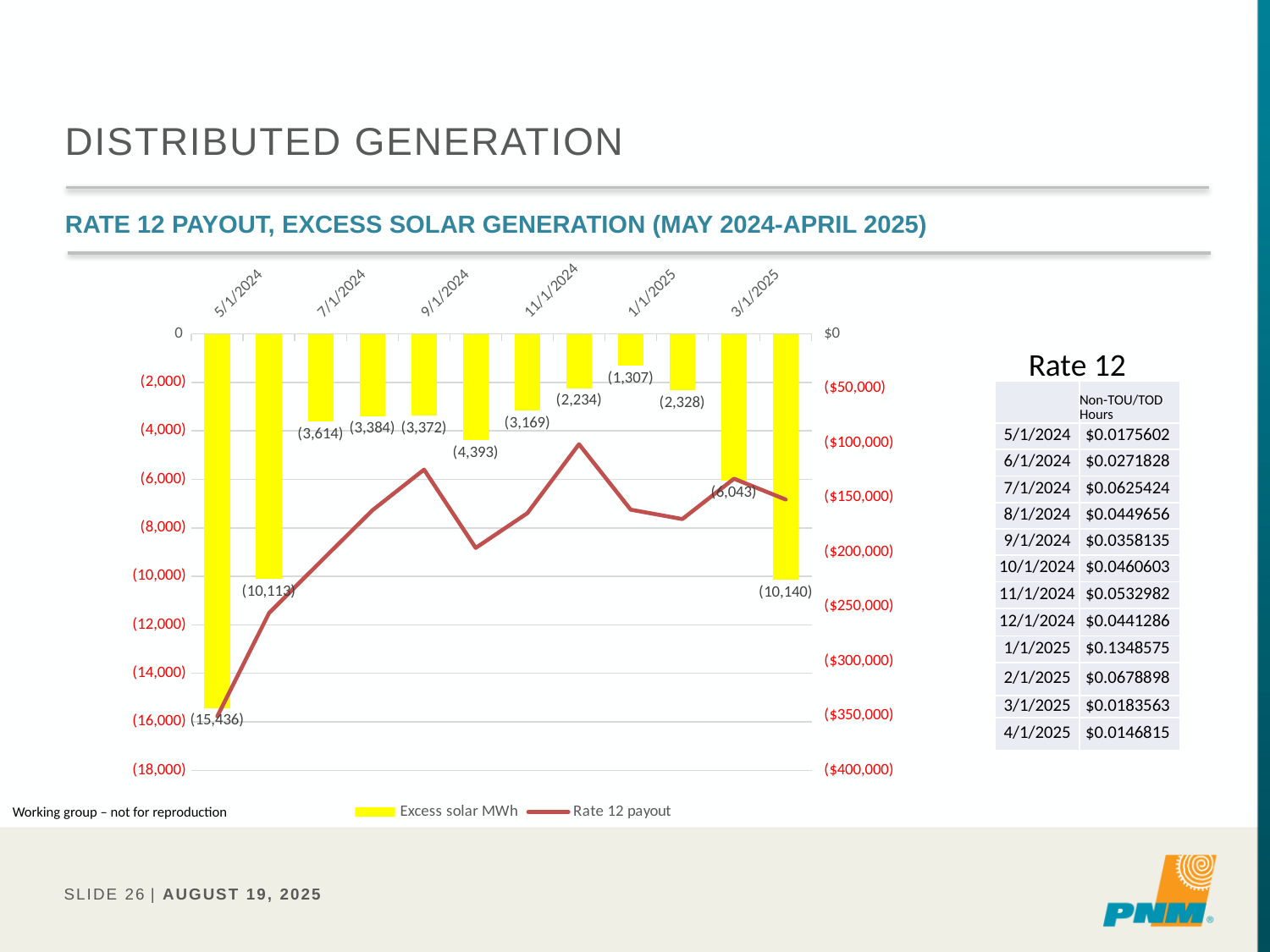
Is the Rate 12 payout value for 5/1/2024 greater or less than ($300,000) on the right axis? less How many Excess solar MWh bars are plotted on the chart? 12 Which has the larger Excess solar MWh magnitude, 9/1/2024 or 11/1/2024? 9/1/2024 Which month has the longest Excess solar MWh bar (largest magnitude)? 5/1/2024 What kind of chart is this? Combined bar and line chart What is the difference in magnitude between the Excess solar MWh bars for 5/1/2024 and 7/1/2024? 11,822 How many series does the chart legend list? 2 What is the Excess solar MWh value shown for 3/1/2025? (6,043) What is the Excess solar MWh value shown for 7/1/2024? (3,614) What is the Excess solar MWh value shown for 1/1/2025? (1,307) What is the Excess solar MWh value shown for 5/1/2024? (15,436) Which month has the shortest Excess solar MWh bar (smallest magnitude)? 1/1/2025